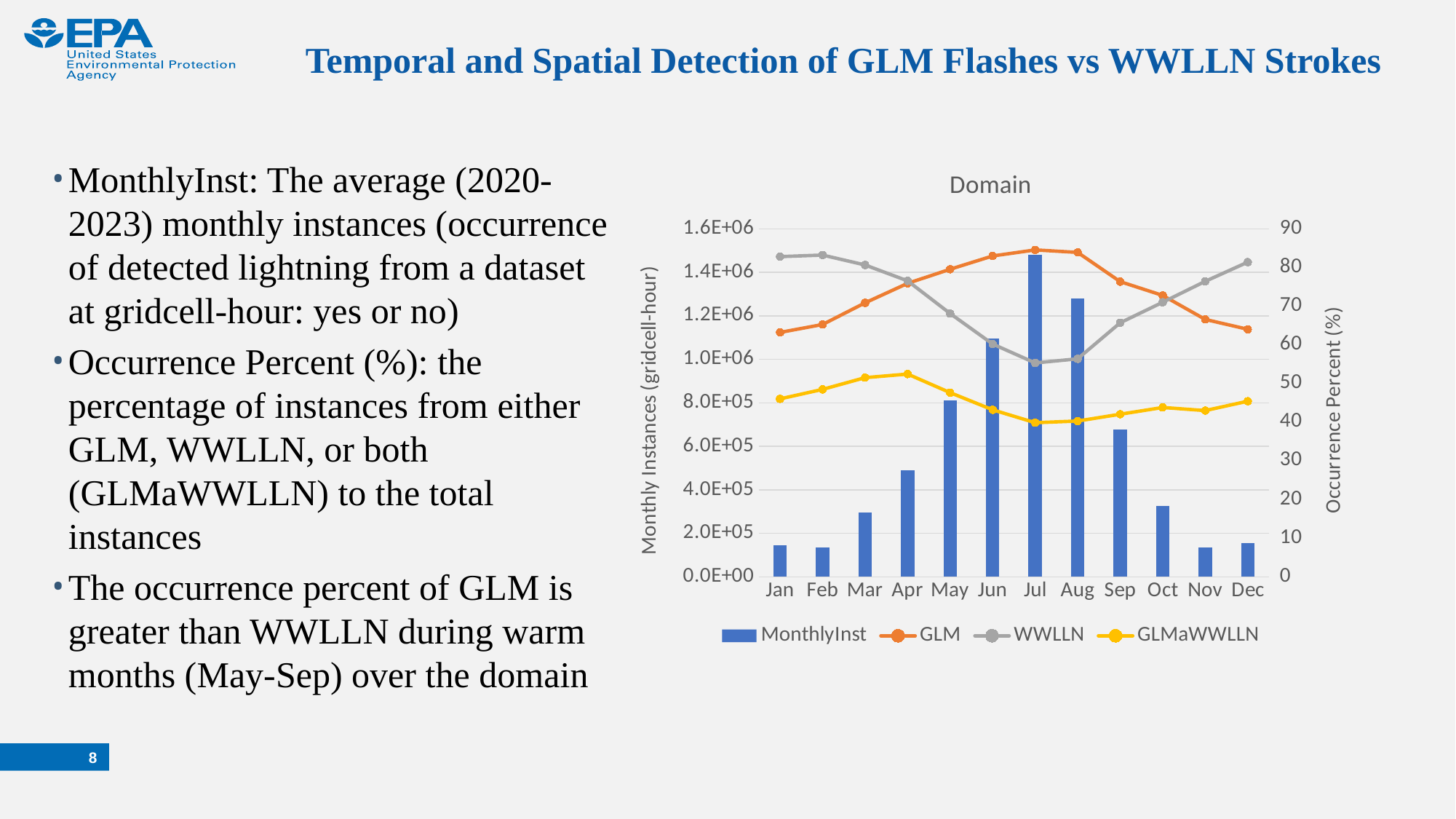
In Jul, which series has the higher occurrence percent, GLM or WWLLN? GLM Does the WWLLN occurrence percent rise or fall from Jan to Jul? fall How many series does the chart legend list? 4 Which month has the highest MonthlyInst bar? Jul Is the MonthlyInst value for Apr greater or less than 6.0E+05? less Is the GLM occurrence percent for Jul greater or less than 80? greater How many months are shown on the x axis of the chart? 12 Is the MonthlyInst value for Jul greater or less than 1.4E+06? greater What kind of chart is shown on the slide? Combined bar and line chart Which month has the higher MonthlyInst bar, Jun or Aug? Aug In Jan, which series has the higher occurrence percent, GLM or WWLLN? WWLLN What is the title of the chart? Domain